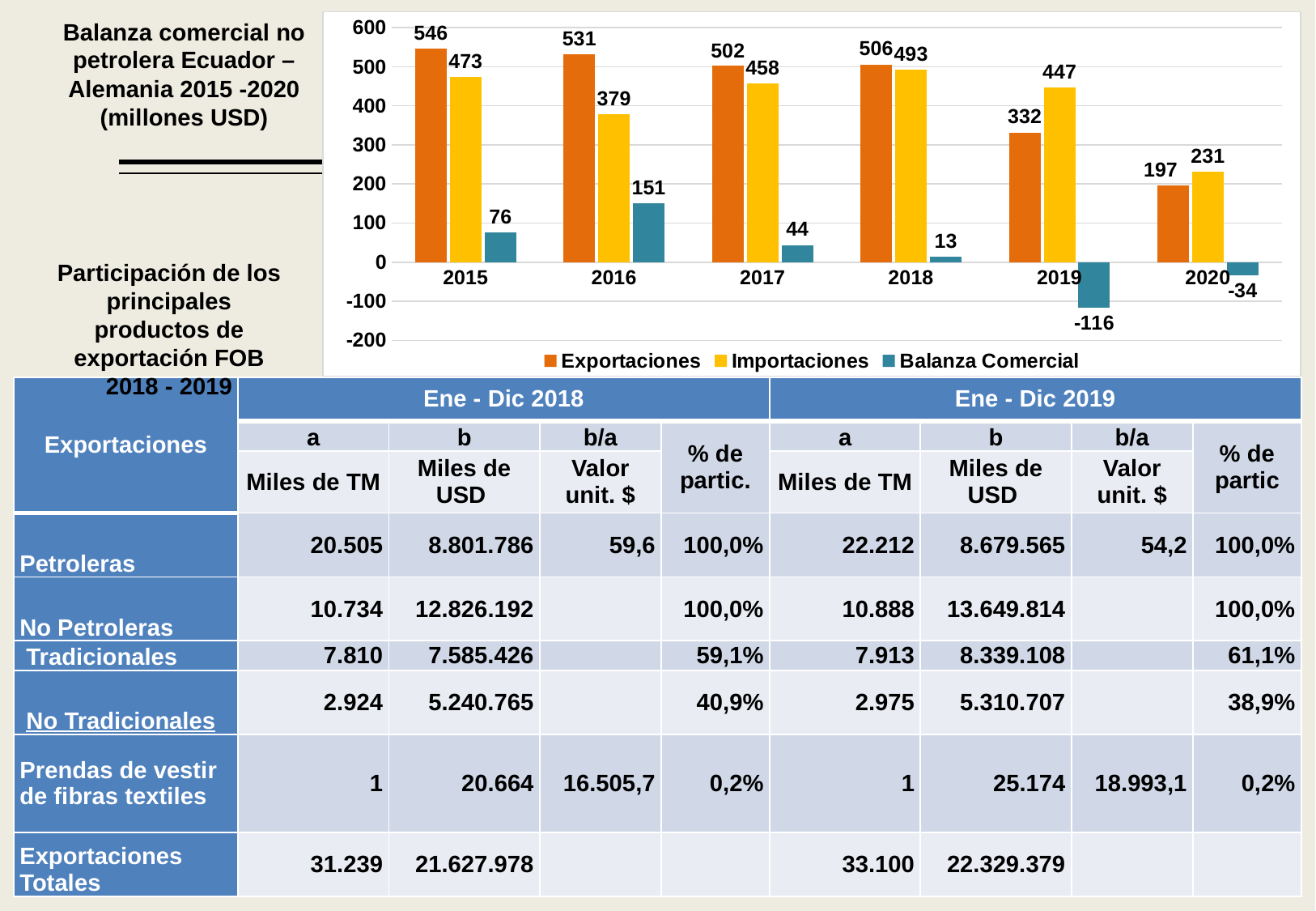
Does Exportaciones rise or fall from 2018 to 2020? Fall What is the value of Importaciones for 2019? 447 How many years are shown on the x axis of the chart? 6 What is the value of Exportaciones for 2015? 546 What is the value of Balanza Comercial for 2019? -116 What is the difference between Exportaciones and Importaciones in 2016? 152 In which year is Importaciones highest? 2018 What is the value of Balanza Comercial for 2016? 151 Which is larger in 2020, Exportaciones or Importaciones? Importaciones In which year is Exportaciones lowest? 2020 How many series does the chart legend list? 3 What kind of chart is shown on the slide? Bar chart